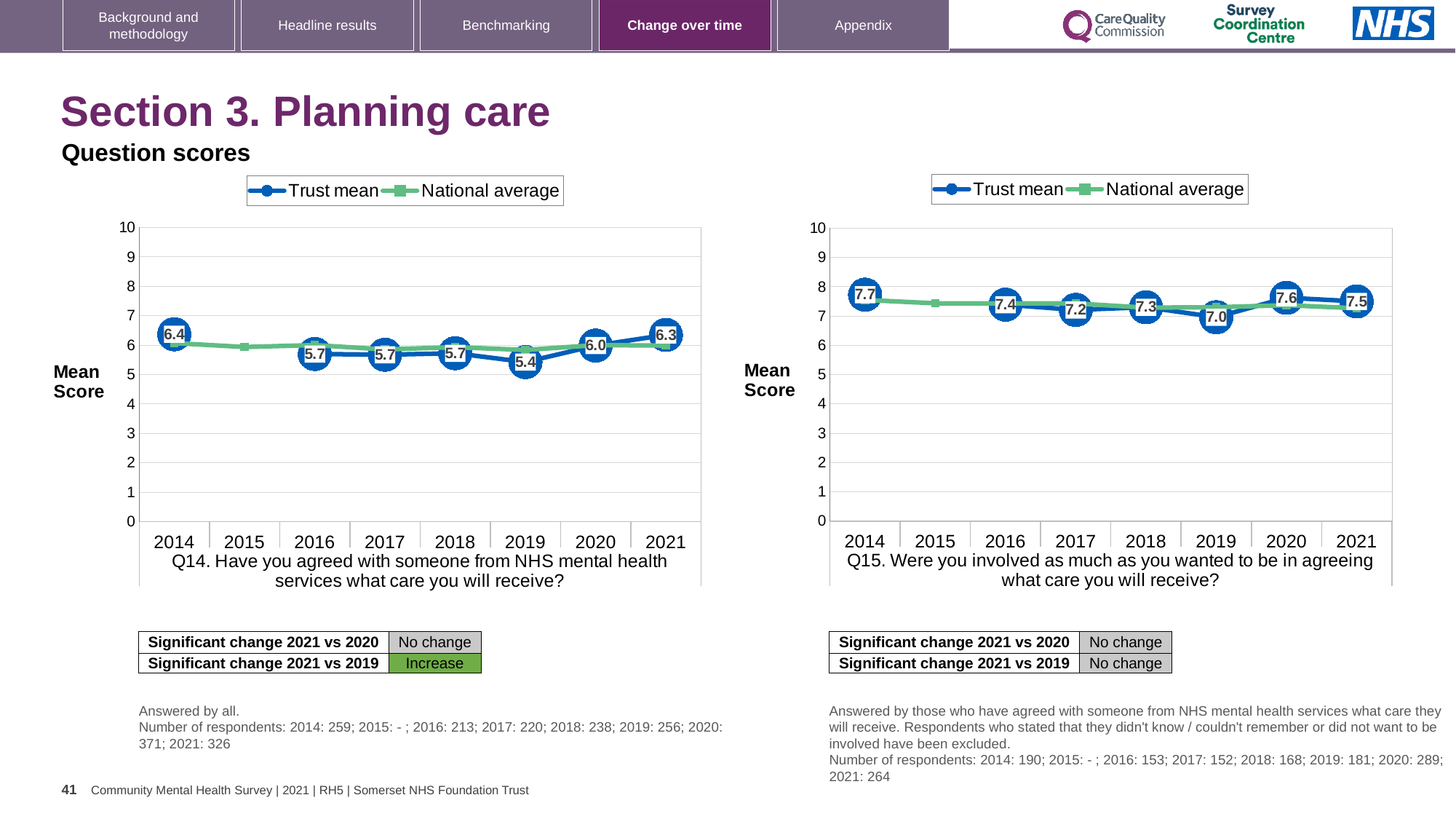
In the Q15 chart on the right, which year has the lowest Trust mean score? 2019 How many series does the legend of the Q15 chart on the right list? 2 In the Q14 chart on the left, what is the difference between the Trust mean scores for 2021 and 2019? 0.9 In the Q14 chart on the left, what is the Trust mean score for 2019? 5.4 In the Q14 chart on the left, which year has the lowest Trust mean score? 2019 In the Q15 chart on the right, is the Trust mean score for 2020 larger or smaller than for 2021? larger In the Q15 chart on the right, which year has the highest Trust mean score? 2014 What type of chart is the Q14 chart on the left? Line chart In the Q15 chart on the right, is the National average value for 2015 greater or less than 7? greater How many years are shown on the x axis of the Q14 chart on the left? 8 In the Q14 chart on the left, what is the Trust mean score for 2014? 6.4 In the Q15 chart on the right, what is the Trust mean score for 2021? 7.5